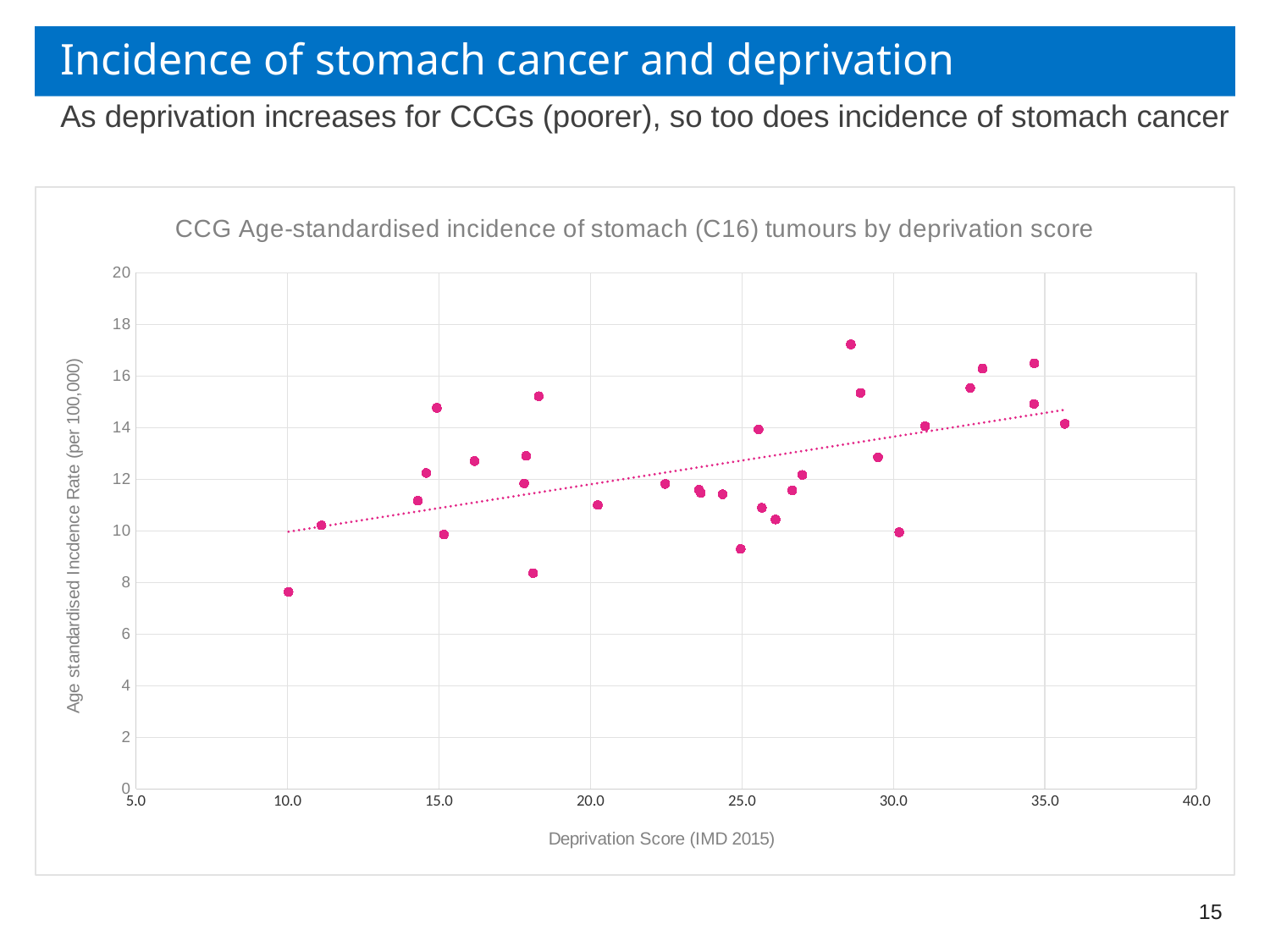
Does the trend line show incidence rising or falling as deprivation score increases? Rising What is the title of the chart? CCG Age-standardised incidence of stomach (C16) tumours by deprivation score Which has the higher incidence rate: the point with the lowest deprivation score (around 10) or the point with the highest deprivation score (around 35.6)? The point with the highest deprivation score Is the incidence rate of the lowest point on the chart greater or less than 8? less Is the incidence rate where the trend line starts (at a deprivation score of about 10) greater or less than 12? less Is the deprivation score of the point with the lowest incidence rate greater or less than 15.0? less What is the label of the x axis of the chart? Deprivation Score (IMD 2015) What kind of chart is shown on the slide? Scatter chart